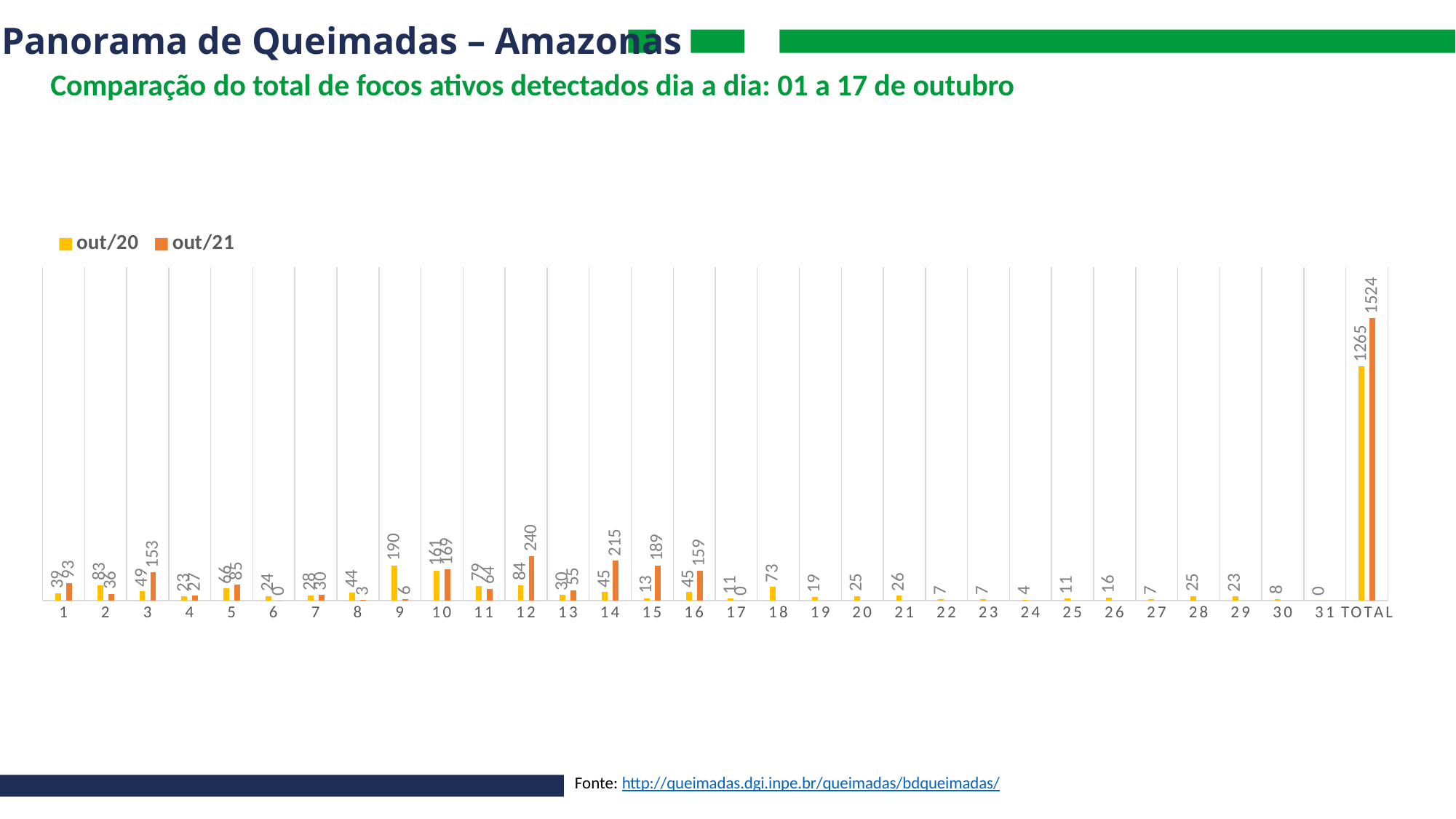
How many series does the legend list? 2 Among days 1 to 31, which day has the highest out/21 value? 12 What are the two series named in the legend? out/20 and out/21 What is the difference between the out/21 and out/20 values for day 14? 170 What is the out/20 value for day 9? 190 What is the out/21 value for day 12? 240 What is the out/20 value for TOTAL? 1265 What is the out/21 value for TOTAL? 1524 For day 3, which series has the larger value, out/20 or out/21? out/21 What is the out/20 value for day 18? 73 What is the difference between the out/21 and out/20 TOTAL values? 259 What kind of chart is shown on the slide? bar chart